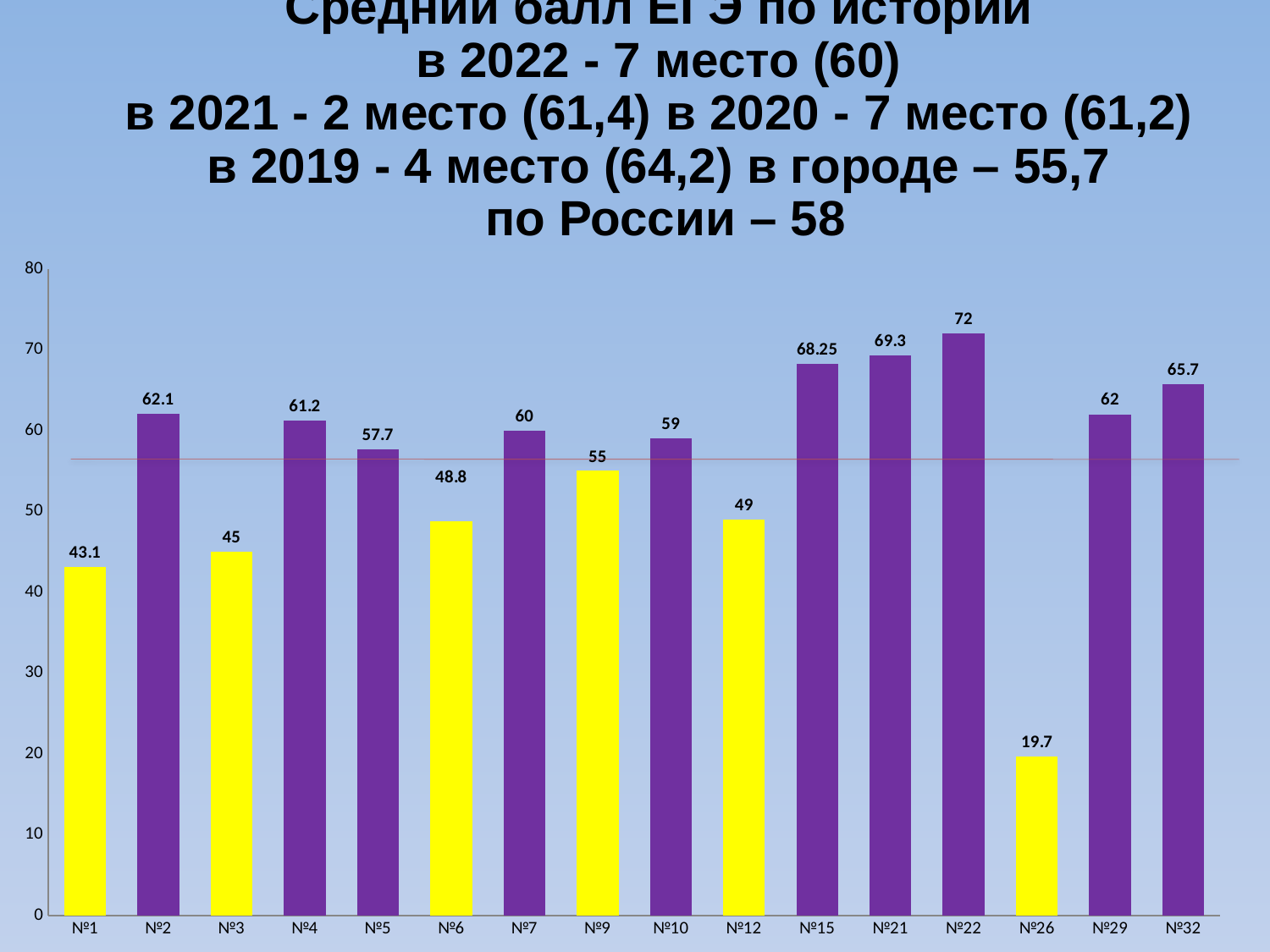
Which is larger, the value for №21 or the value for №32? №21 Which category has the lowest value? №26 What is the value for №15? 68.25 What type of chart is shown on the slide? bar chart What is the value for №6? 48.8 What is the value for №22? 72 What is the value for №26? 19.7 What is the difference between the values for №2 and №1? 19 Which category has the highest value? №22 What is the difference between the values for №22 and №26? 52.3 How many categories are shown on the x axis? 16 How many bars are coloured yellow? 6